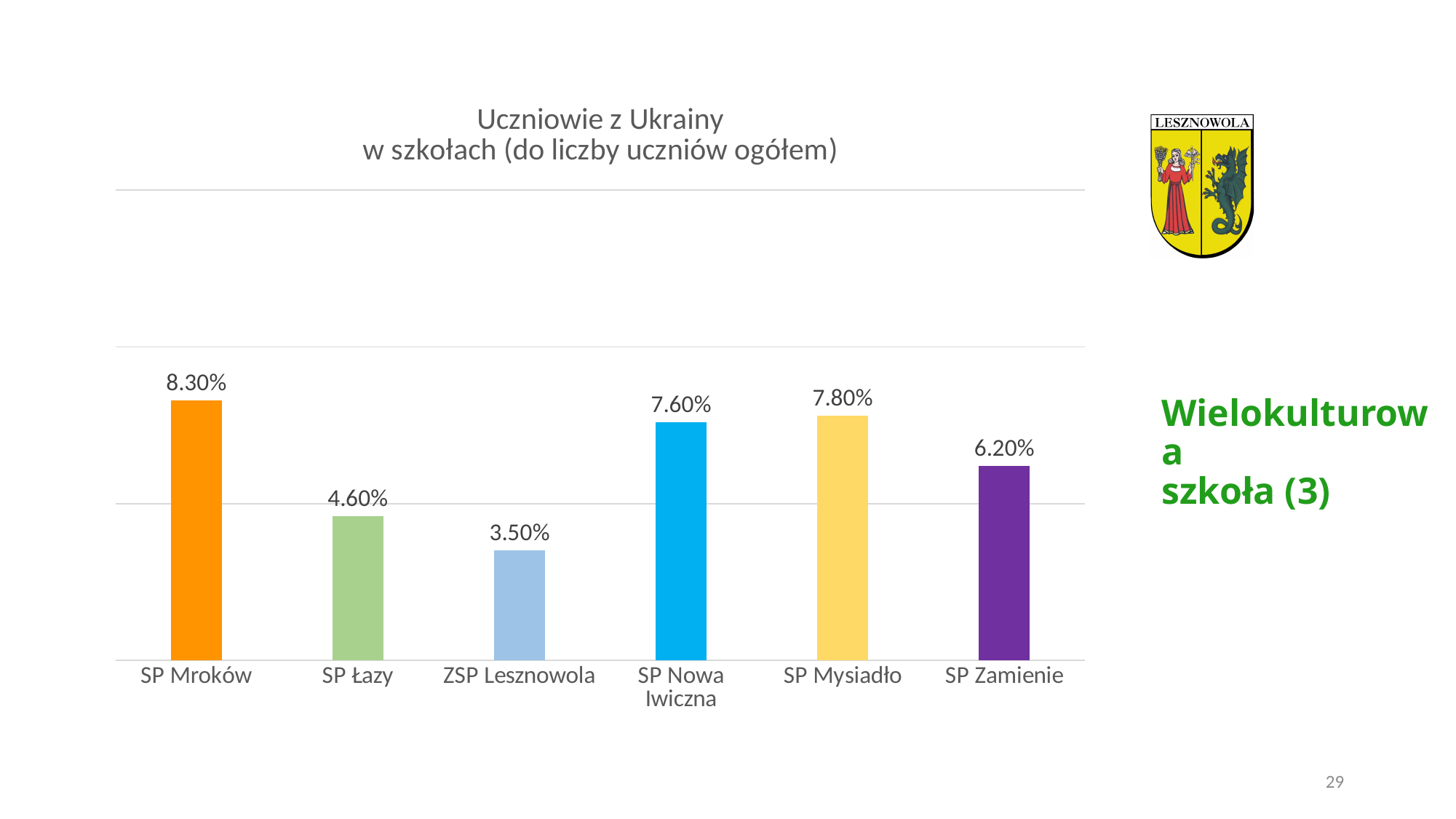
Which school has the highest value? SP Mroków What is the value for SP Nowa Iwiczna? 7.60% What is the value for SP Zamienie? 6.20% How many schools are shown on the chart? 6 Which school has the lowest value? ZSP Lesznowola What is the title of the chart? Uczniowie z Ukrainy w szkołach (do liczby uczniów ogółem) What is the difference between the values for SP Mysiadło and SP Zamienie? 1.60% What is the difference between the values for SP Mroków and SP Łazy? 3.70% What is the value for SP Mroków? 8.30% Which is larger, the value for SP Łazy or the value for SP Zamienie? SP Zamienie What kind of chart is shown on the slide? Bar chart What is the value for ZSP Lesznowola? 3.50%